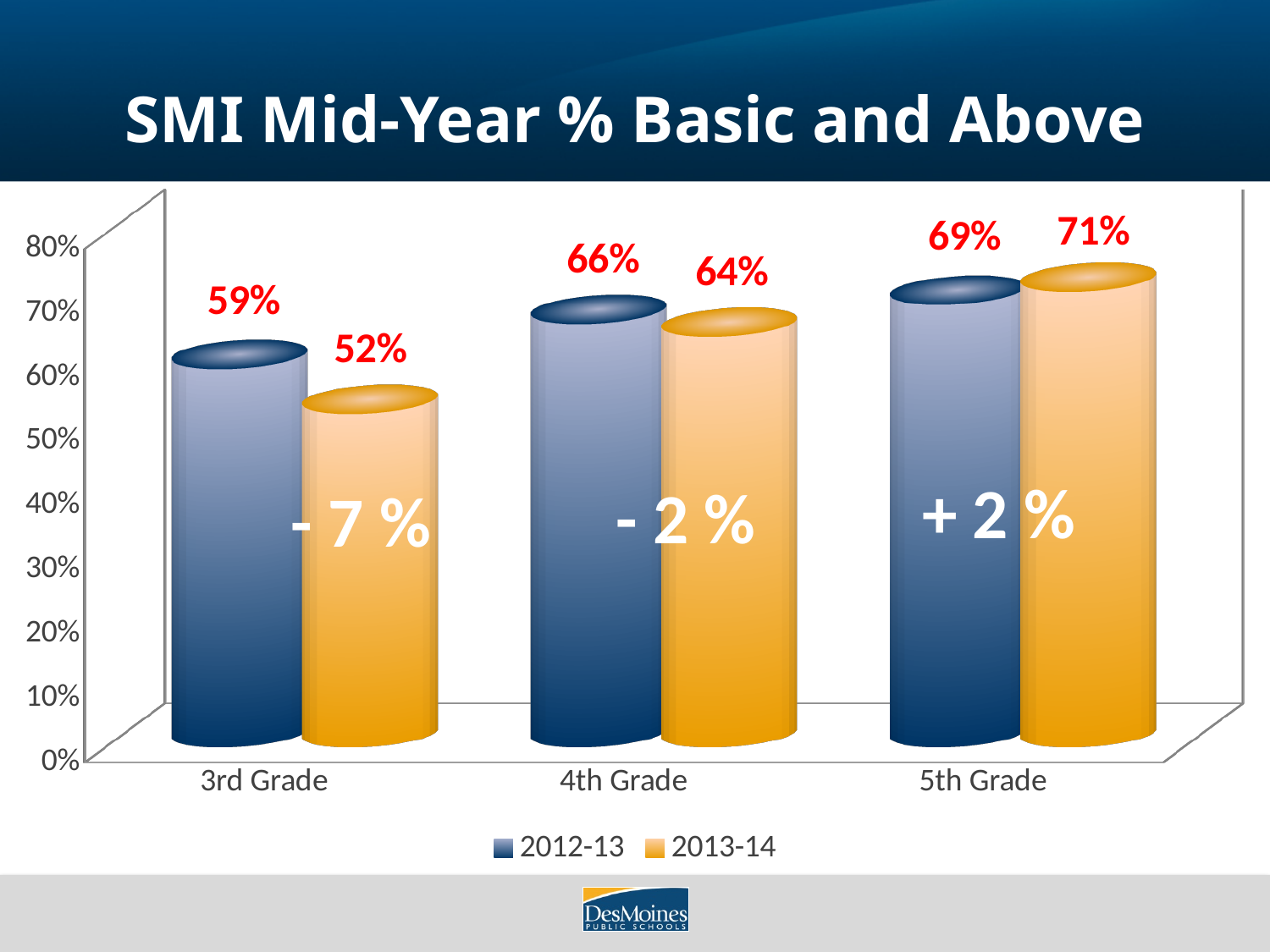
What is the value for 3rd Grade in the 2012-13 series? 59% Which grade has the highest value in the 2013-14 series? 5th Grade Which grade has the lowest value in the 2012-13 series? 3rd Grade What is the value for 5th Grade in the 2012-13 series? 69% How many series does the legend list? 2 What is the value for 4th Grade in the 2013-14 series? 64% Do the 2013-14 values rise or fall from 3rd Grade to 5th Grade? Rise What is the value for 3rd Grade in the 2013-14 series? 52% What kind of chart is shown on the slide? Bar chart What is the difference between the 2012-13 and 2013-14 values for 3rd Grade? 7% How many grade categories are shown on the x axis? 3 Which is larger for 4th Grade, the 2012-13 value or the 2013-14 value? 2012-13